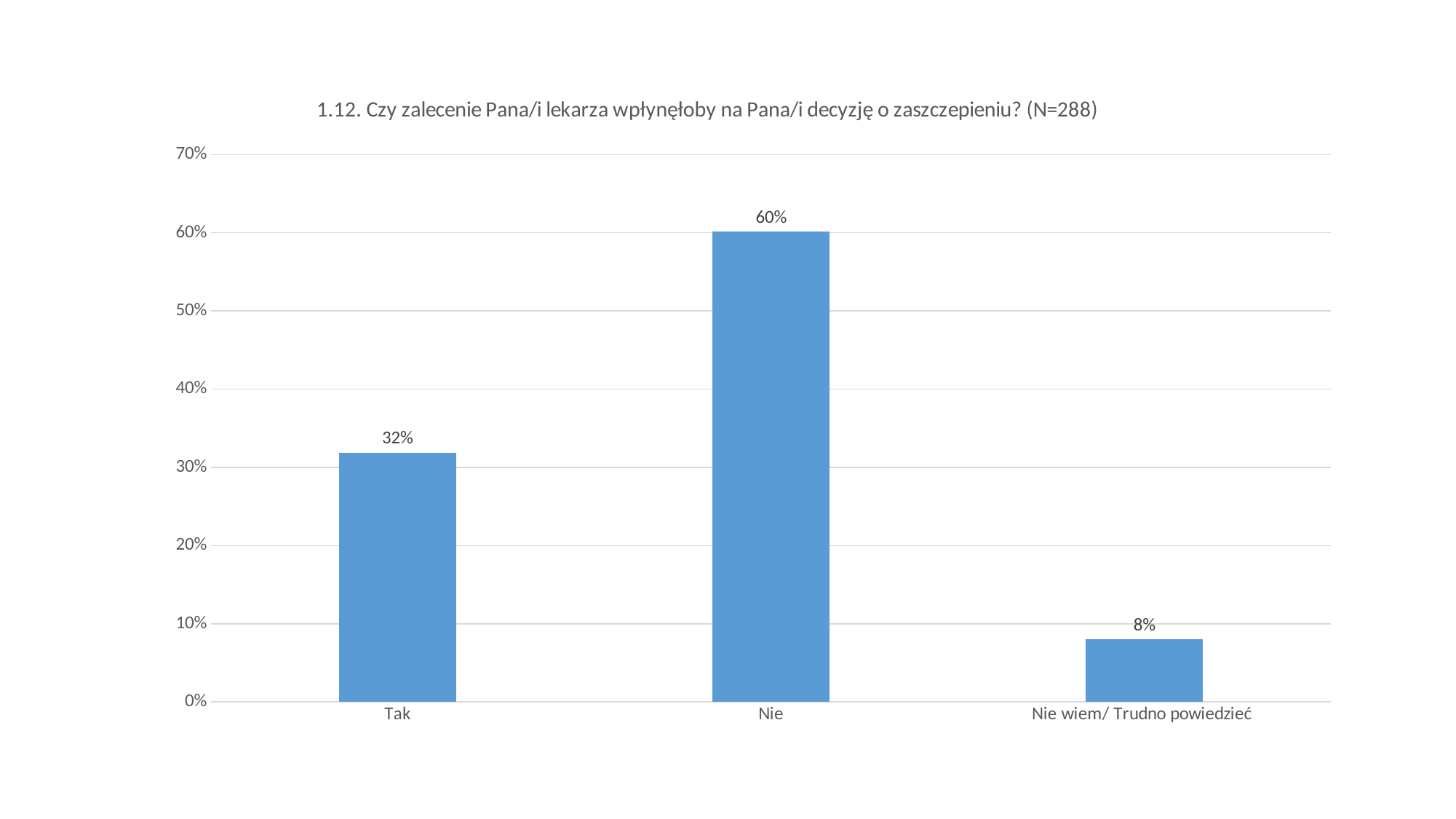
What is the value for "Nie wiem/ Trudno powiedzieć"? 8% How many categories are shown on the x axis? 3 What kind of chart is shown on the slide? Bar chart What is the value for "Tak"? 32% Which category has the highest value? Nie What sample size (N) is given in the chart title? N=288 What is the difference between the values for "Nie" and "Tak"? 28% Which category has the lowest value? Nie wiem/ Trudno powiedzieć What is the value for "Nie"? 60% Which is larger, the value for "Tak" or the value for "Nie"? Nie Is the value for "Nie" greater or less than 50%? greater What is the difference between the values for "Tak" and "Nie wiem/ Trudno powiedzieć"? 24%